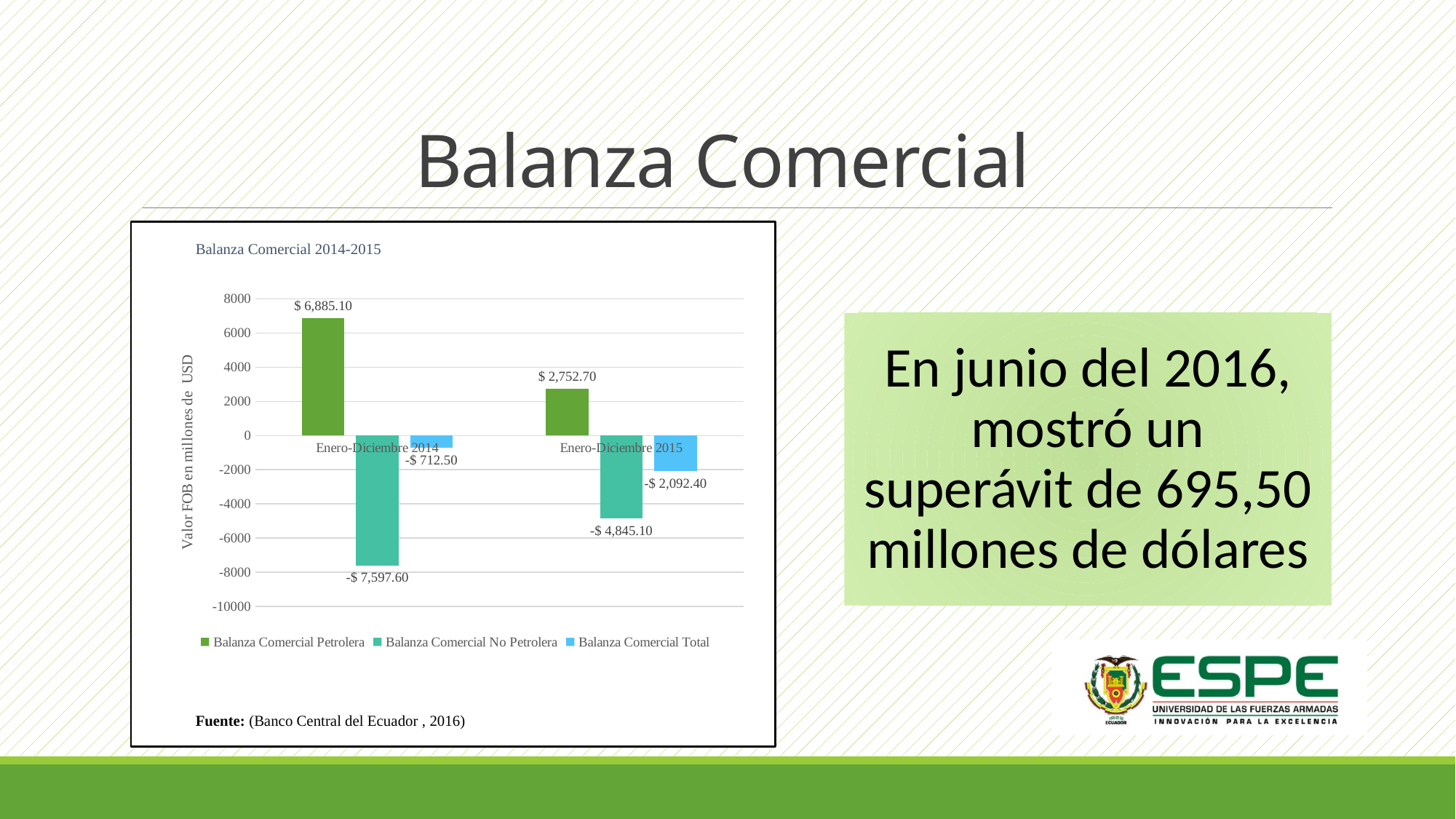
What kind of chart is shown on the slide? bar chart What is the value of Balanza Comercial No Petrolera for Enero-Diciembre 2015? -$ 4,845.10 What is the title of the chart? Balanza Comercial 2014-2015 How many series does the legend list? 3 What is the value of Balanza Comercial Petrolera for Enero-Diciembre 2014? $ 6,885.10 Is the Balanza Comercial Total for Enero-Diciembre 2015 larger or smaller than for Enero-Diciembre 2014? smaller What is the value of Balanza Comercial Total for Enero-Diciembre 2014? -$ 712.50 What is the value of Balanza Comercial Petrolera for Enero-Diciembre 2015? $ 2,752.70 How many periods are shown on the x axis? 2 By how much did Balanza Comercial Petrolera fall from Enero-Diciembre 2014 to Enero-Diciembre 2015? $ 4,132.40 Which period has the lowest Balanza Comercial No Petrolera value? Enero-Diciembre 2014 Which period has the higher Balanza Comercial Petrolera value? Enero-Diciembre 2014